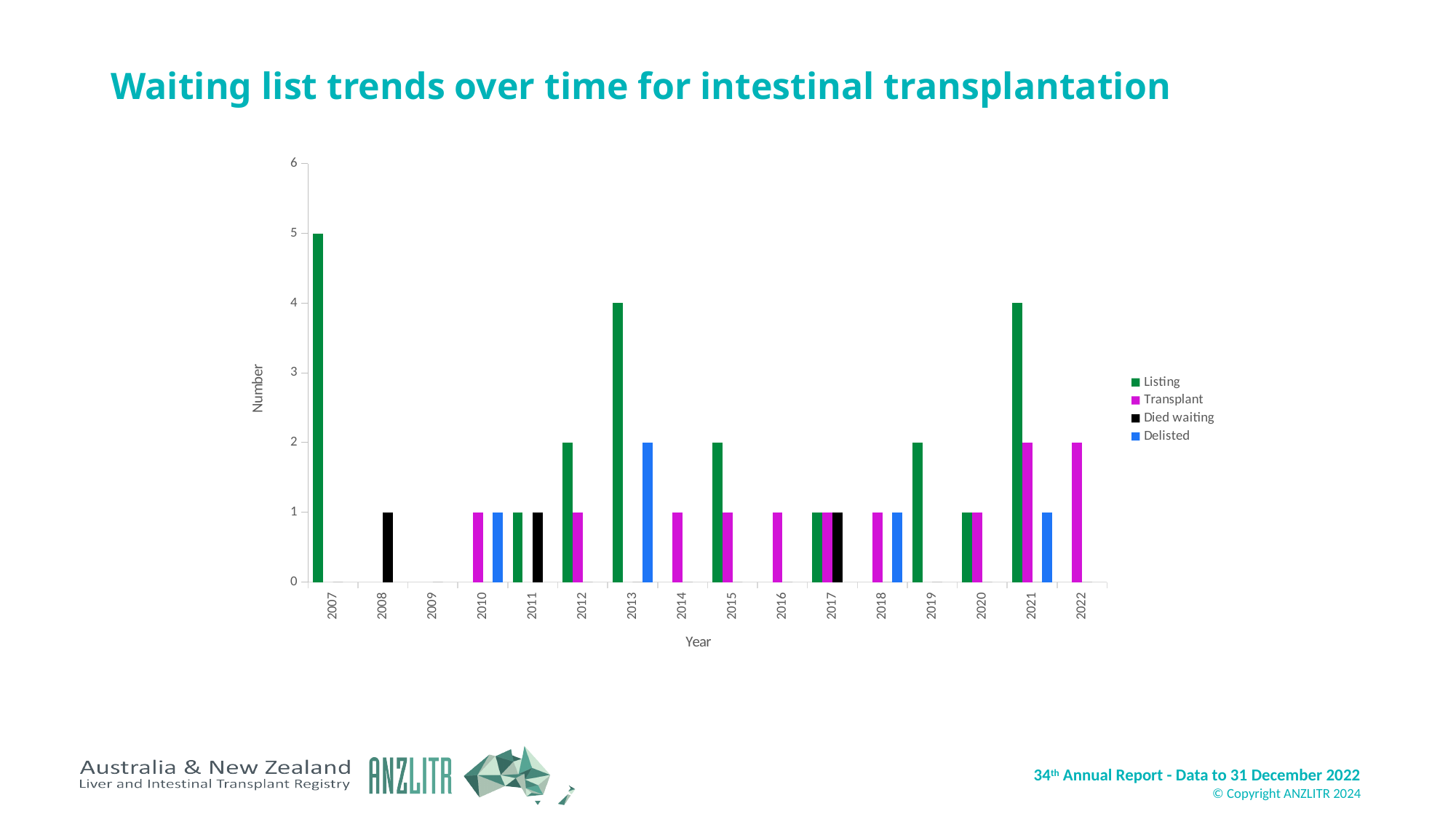
How many years are shown on the x axis? 16 What is the Listing value for 2007? 5 How many series does the legend list? 4 Which series is shown in black in the legend? Died waiting What is the title of the chart? Waiting list trends over time for intestinal transplantation Which year has the highest Listing value? 2007 What kind of chart is shown on the slide? bar chart What is the Delisted value for 2013? 2 What is the difference between the Listing value in 2007 and the Listing value in 2013? 1 Which is larger, the Listing value in 2021 or the Transplant value in 2021? Listing Is the Listing value for 2007 greater or less than 4? greater What is the Transplant value for 2022? 2